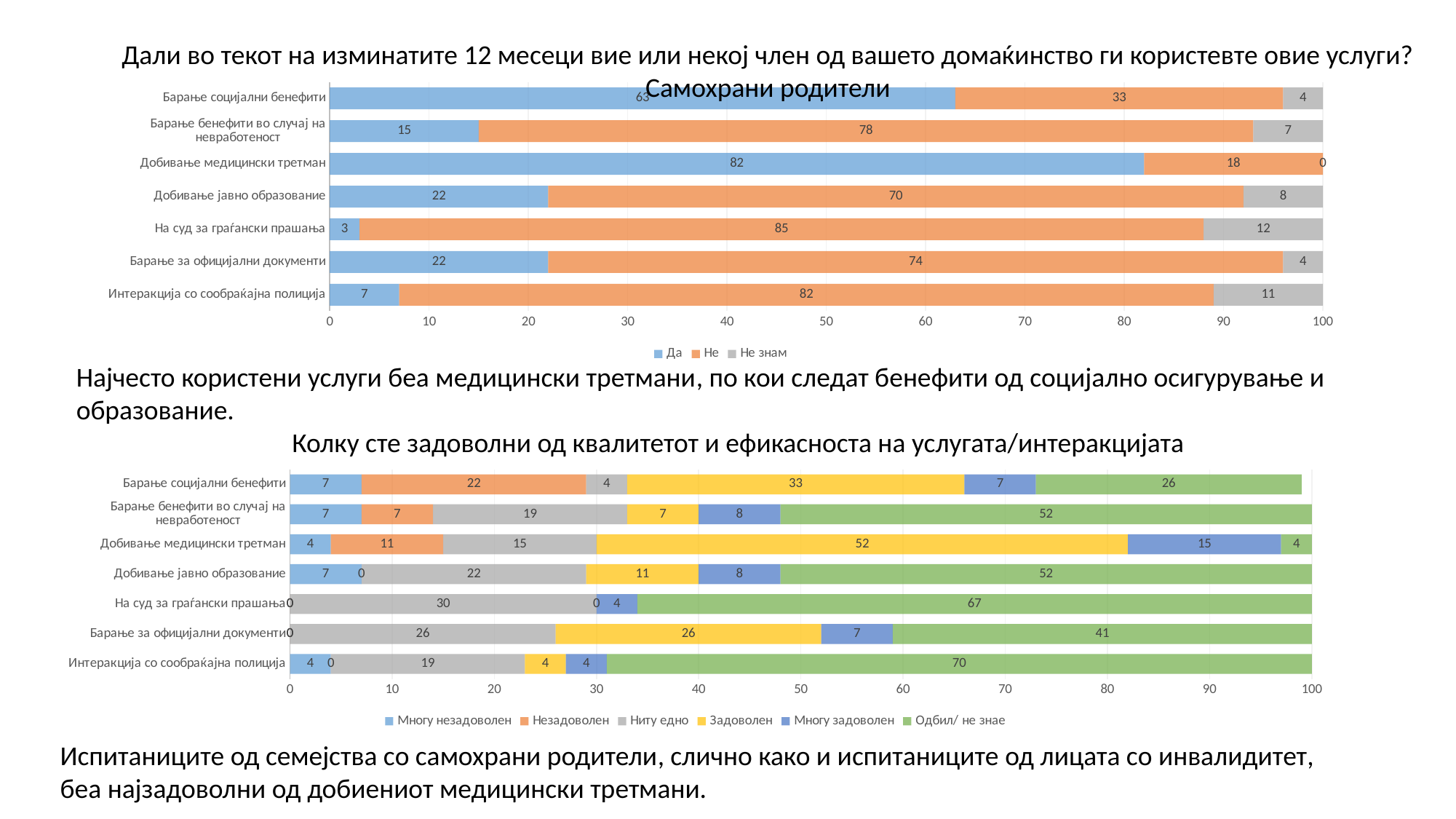
In the bottom chart (Колку сте задоволни...), which category has the highest 'Задоволен' value? Добивање медицински третман In the top chart (Самохрани родители), what is the 'Да' value for 'Добивање медицински третман'? 82 In the bottom chart (Колку сте задоволни...), what is the 'Задоволен' value for 'Добивање медицински третман'? 52 In the bottom chart (Колку сте задоволни...), how many series does the legend list? 6 In the top chart (Самохрани родители), what is the 'Не' value for 'На суд за граѓански прашања'? 85 In the bottom chart (Колку сте задоволни...), what is the 'Одбил/ не знае' value for 'Интеракција со сообраќајна полиција'? 70 In the top chart (Самохрани родители), what is the difference between the 'Да' values for 'Барање социјални бенефити' and 'Барање бенефити во случај на невработеност'? 48 In the top chart (Самохрани родители), which category has the highest 'Да' value? Добивање медицински третман What type of chart is the bottom chart (Колку сте задоволни...)? Stacked bar chart In the top chart (Самохрани родители), how many series does the legend list? 3 In the bottom chart (Колку сте задоволни...), is the 'Незадоволен' value for 'Барање социјални бенефити' larger or smaller than the 'Незадоволен' value for 'Добивање медицински третман'? larger In the top chart (Самохрани родители), which category has the lowest 'Да' value? На суд за граѓански прашања